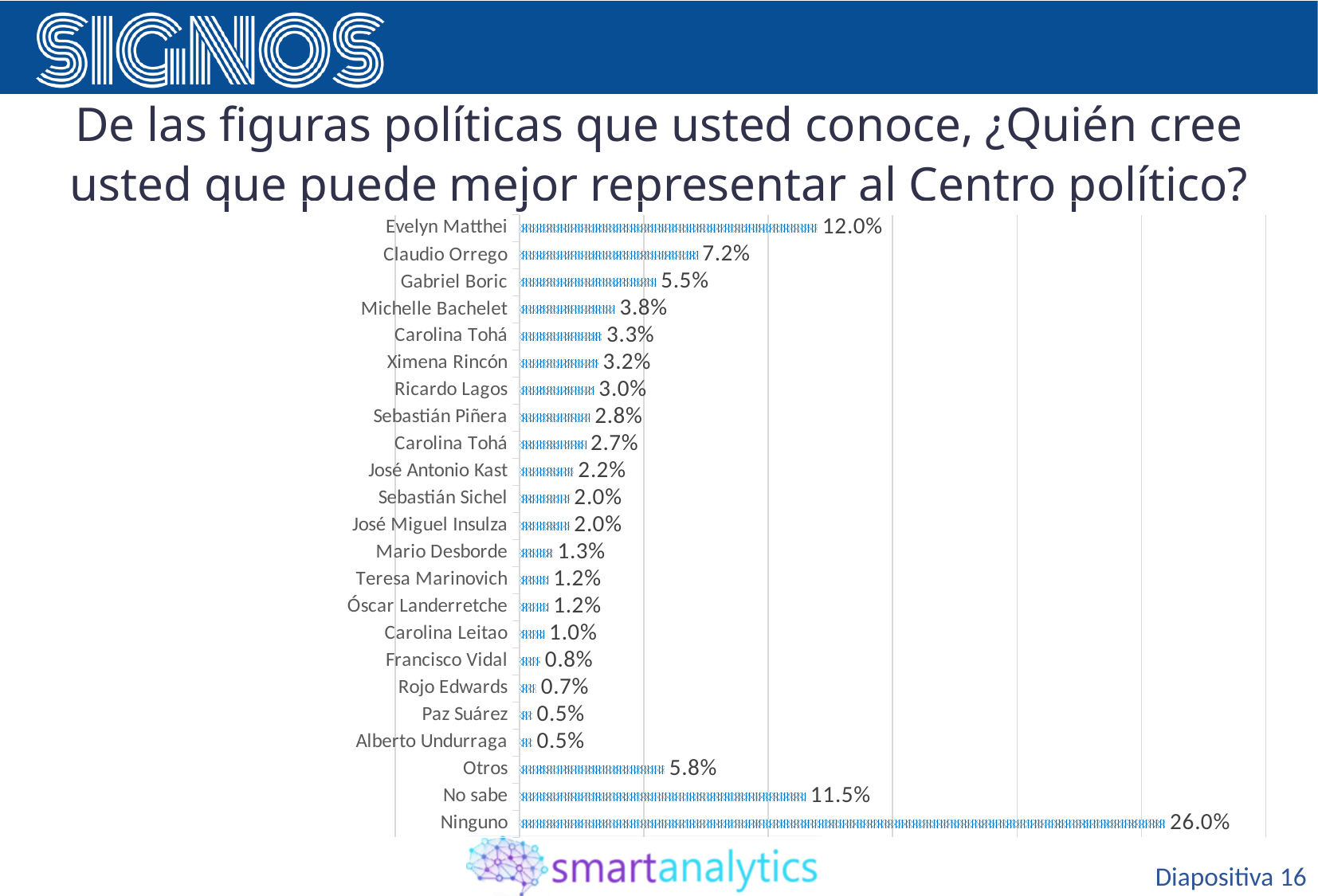
Which is larger, the value for Gabriel Boric or the value for Michelle Bachelet? Gabriel Boric What value is shown for Ninguno? 26.0% What is the difference between the values for Evelyn Matthei and Claudio Orrego? 4.8% What kind of chart is shown on the slide? Bar chart What value is shown for Evelyn Matthei? 12.0% What is the difference between the values for Ninguno and Evelyn Matthei? 14.0% What value is shown for Claudio Orrego? 7.2% Which category has the highest value in the chart? Ninguno What value is shown for José Antonio Kast? 2.2% What value is shown for No sabe? 11.5% How many categories are shown in the chart? 23 Which named political figure has the highest value in the chart? Evelyn Matthei